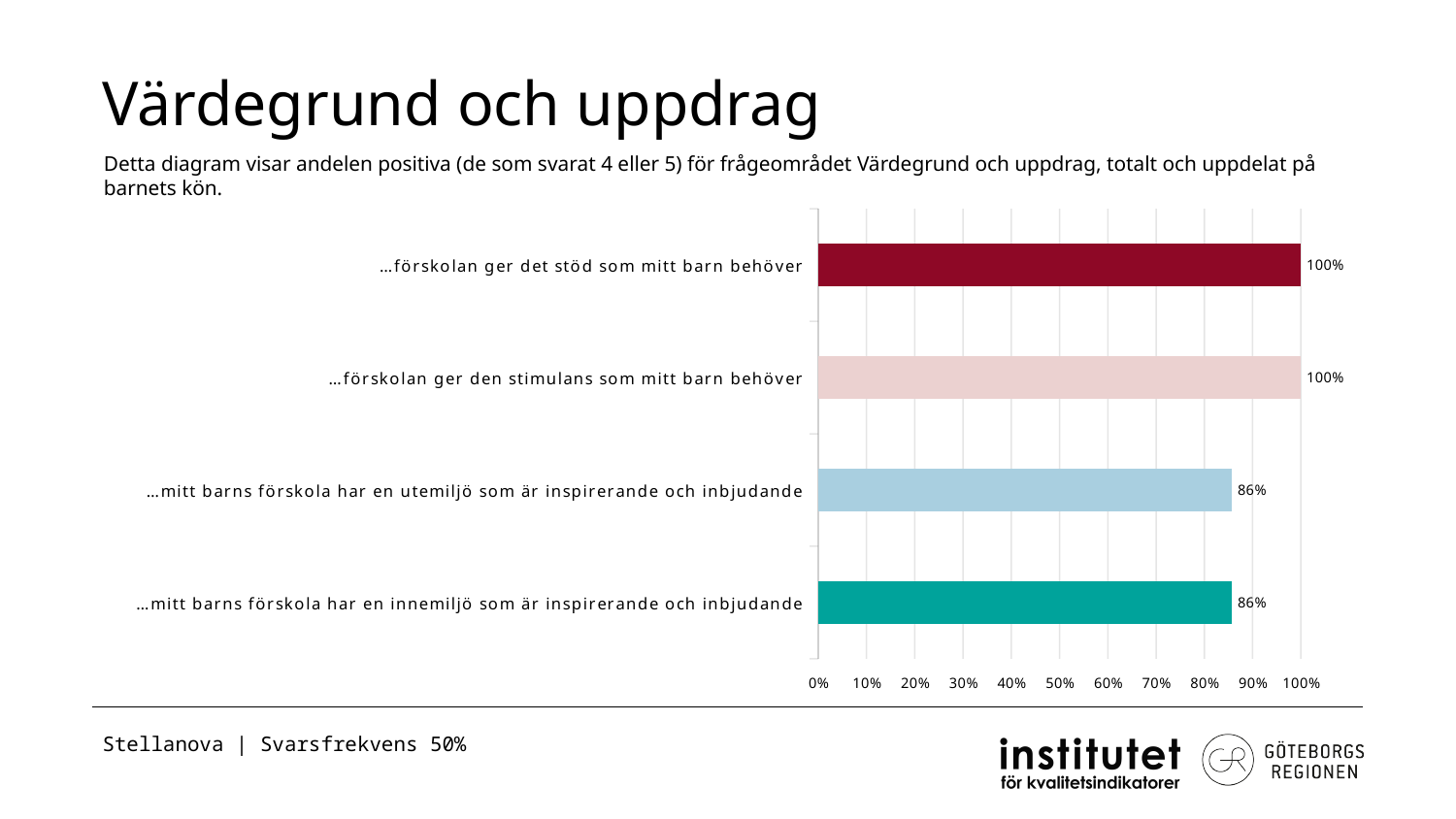
How many categories are shown in the chart? 4 Is the value for "…mitt barns förskola har en innemiljö som är inspirerande och inbjudande" greater or less than 90%? less What is the highest value shown on the x axis of the chart? 100% What is the value for "…förskolan ger den stimulans som mitt barn behöver"? 100% What is the value for "…mitt barns förskola har en utemiljö som är inspirerande och inbjudande"? 86% What kind of chart is shown on the slide? Bar chart What is the title of the slide containing the chart? Värdegrund och uppdrag Which is larger: the value for "…förskolan ger den stimulans som mitt barn behöver" or the value for "…mitt barns förskola har en utemiljö som är inspirerande och inbjudande"? …förskolan ger den stimulans som mitt barn behöver What is the value for "…förskolan ger det stöd som mitt barn behöver"? 100% What is the value for "…mitt barns förskola har en innemiljö som är inspirerande och inbjudande"? 86% What is the difference between the value for "…förskolan ger det stöd som mitt barn behöver" and the value for "…mitt barns förskola har en innemiljö som är inspirerande och inbjudande"? 14 percentage points Is the value for "…mitt barns förskola har en utemiljö som är inspirerande och inbjudande" greater or less than 80%? greater